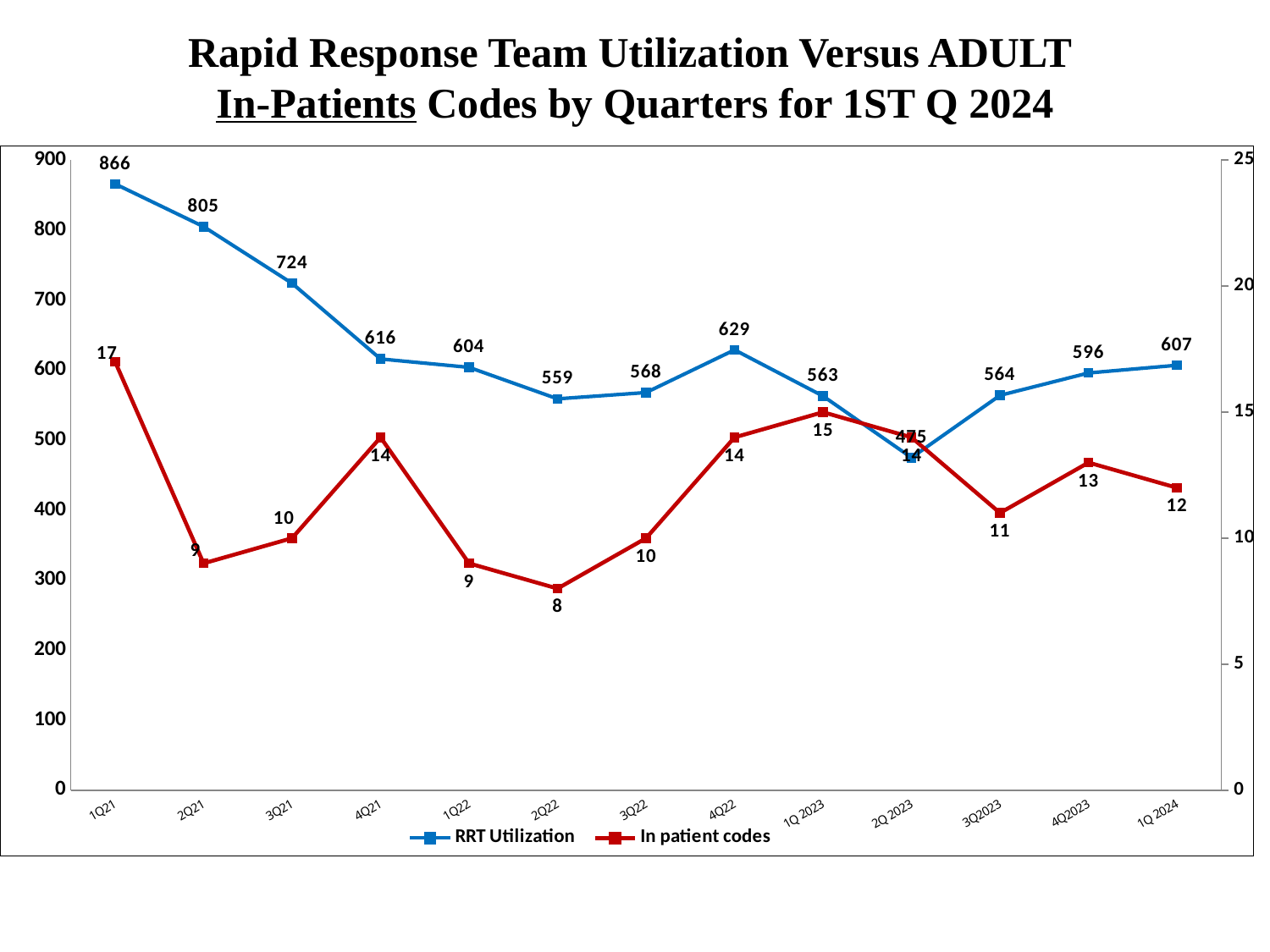
Which quarter has the lowest RRT Utilization? 2Q 2023 What is the RRT Utilization value for 1Q21? 866 Does RRT Utilization rise or fall from 1Q21 to 4Q21? Fall Which is larger, the In patient codes value for 1Q21 or for 1Q 2023? 1Q21 Which quarter has the highest RRT Utilization? 1Q21 What is the In patient codes value for 2Q22? 8 What is the difference in RRT Utilization between 1Q21 and 2Q21? 61 How many quarters are plotted on the x axis? 13 Which quarter has the lowest In patient codes value? 2Q22 How many series does the legend list? 2 What is the RRT Utilization value for 1Q 2024? 607 What kind of chart is shown on the slide? Line chart